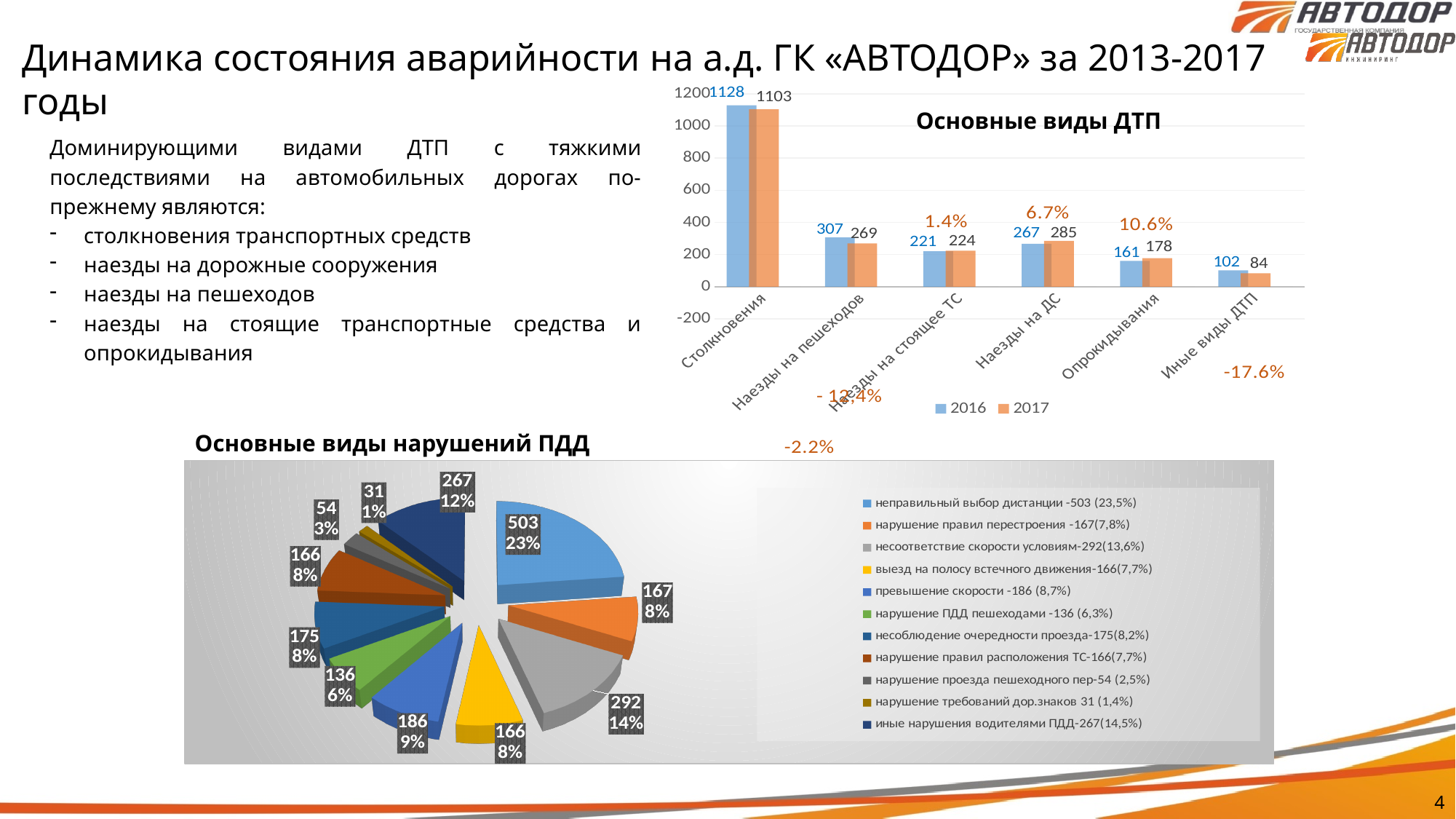
On the pie chart «Основные виды нарушений ПДД», how many entries does the legend list? 11 On the chart titled «Основные виды ДТП», which category has the lowest value in 2016? Иные виды ДТП On the chart titled «Основные виды ДТП», how many series does the legend list? 2 What kind of chart is «Основные виды нарушений ПДД»? Pie chart On the chart titled «Основные виды ДТП», what is the value for «Наезды на пешеходов» in 2017? 269 On the pie chart «Основные виды нарушений ПДД», what share does the slice with value 503 («неправильный выбор дистанции») have? 23% On the chart titled «Основные виды ДТП», which is larger for «Наезды на ДС»: the 2016 value or the 2017 value? 2017 On the chart titled «Основные виды ДТП», which category has the highest value in 2017? Столкновения On the chart titled «Основные виды ДТП», what is the value for «Столкновения» in 2016? 1128 On the chart titled «Основные виды ДТП», what is the difference between the 2016 and 2017 values for «Столкновения»? 25 On the chart titled «Основные виды ДТП», what is the value for «Опрокидывания» in 2017? 178 On the chart titled «Основные виды ДТП», how many categories are shown on the x axis? 6